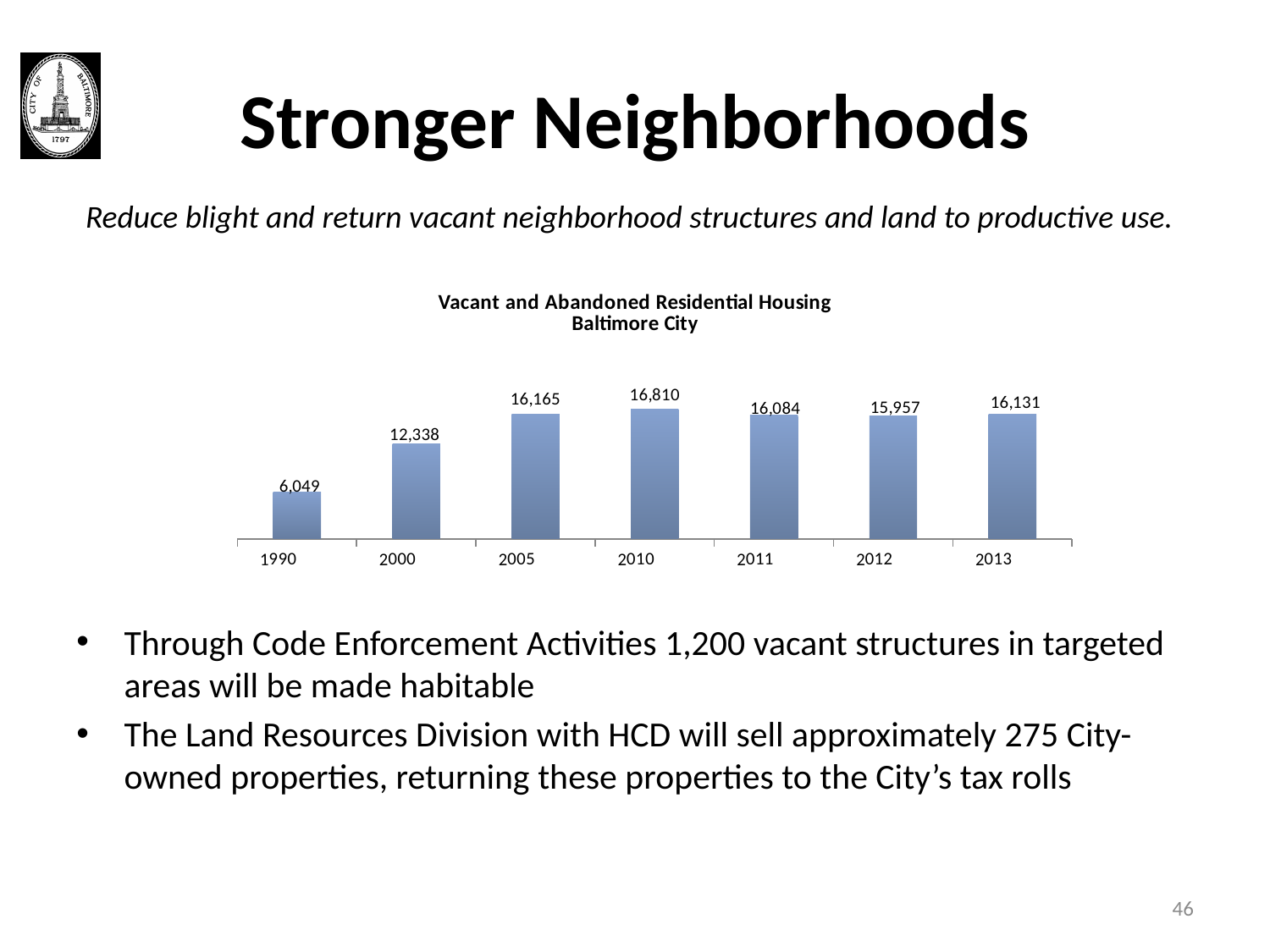
Do the values rise or fall from 1990 to 2010? rise What is the value for 2012? 15,957 How many years are shown on the x axis? 7 What is the value for 1990? 6,049 What is the title of the chart? Vacant and Abandoned Residential Housing Baltimore City What is the difference between the values for 2000 and 1990? 6,289 What is the difference between the values for 2010 and 2013? 679 What kind of chart is shown on the slide? bar chart Which year has the lowest value? 1990 Which year has the highest value? 2010 Which is larger, the value for 2005 or the value for 2000? 2005 What is the value for 2010? 16,810